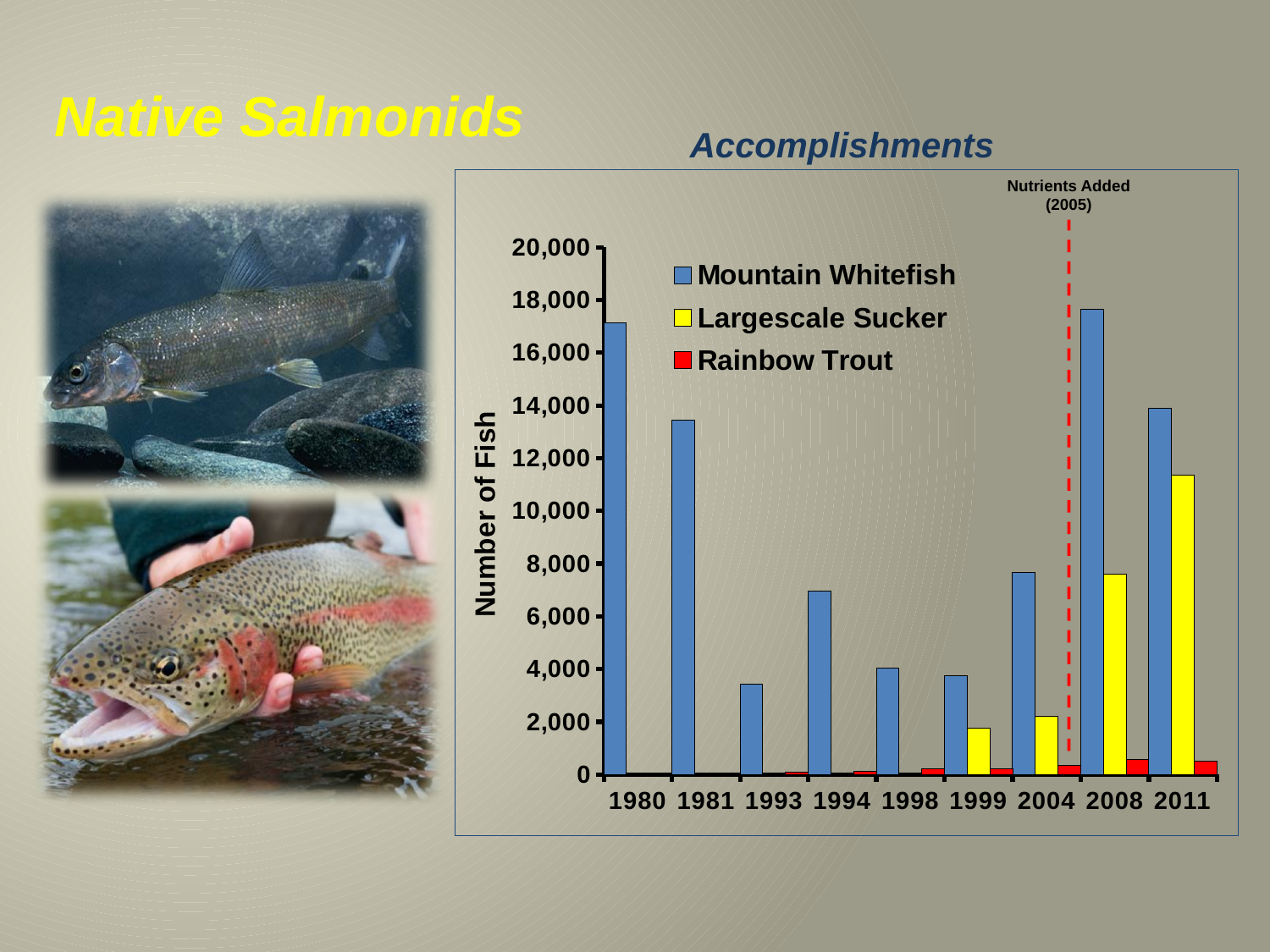
In which year is the Largescale Sucker value highest? 2011 In which year is the Largescale Sucker value lowest? 1999 Is the Largescale Sucker value for 2011 greater or less than 10,000? greater What kind of chart is shown on the slide? bar chart Is the Mountain Whitefish value for 1980 greater or less than 16,000? greater What event does the red dashed vertical line on the chart mark? Nutrients Added (2005) Is the Mountain Whitefish value for 1993 greater or less than 4,000? less How many series does the chart legend list? 3 In 2011, which series has the larger value, Mountain Whitefish or Largescale Sucker? Mountain Whitefish How many years are shown on the x axis of the chart? 9 Which is larger, the Mountain Whitefish value for 1981 or for 1994? 1981